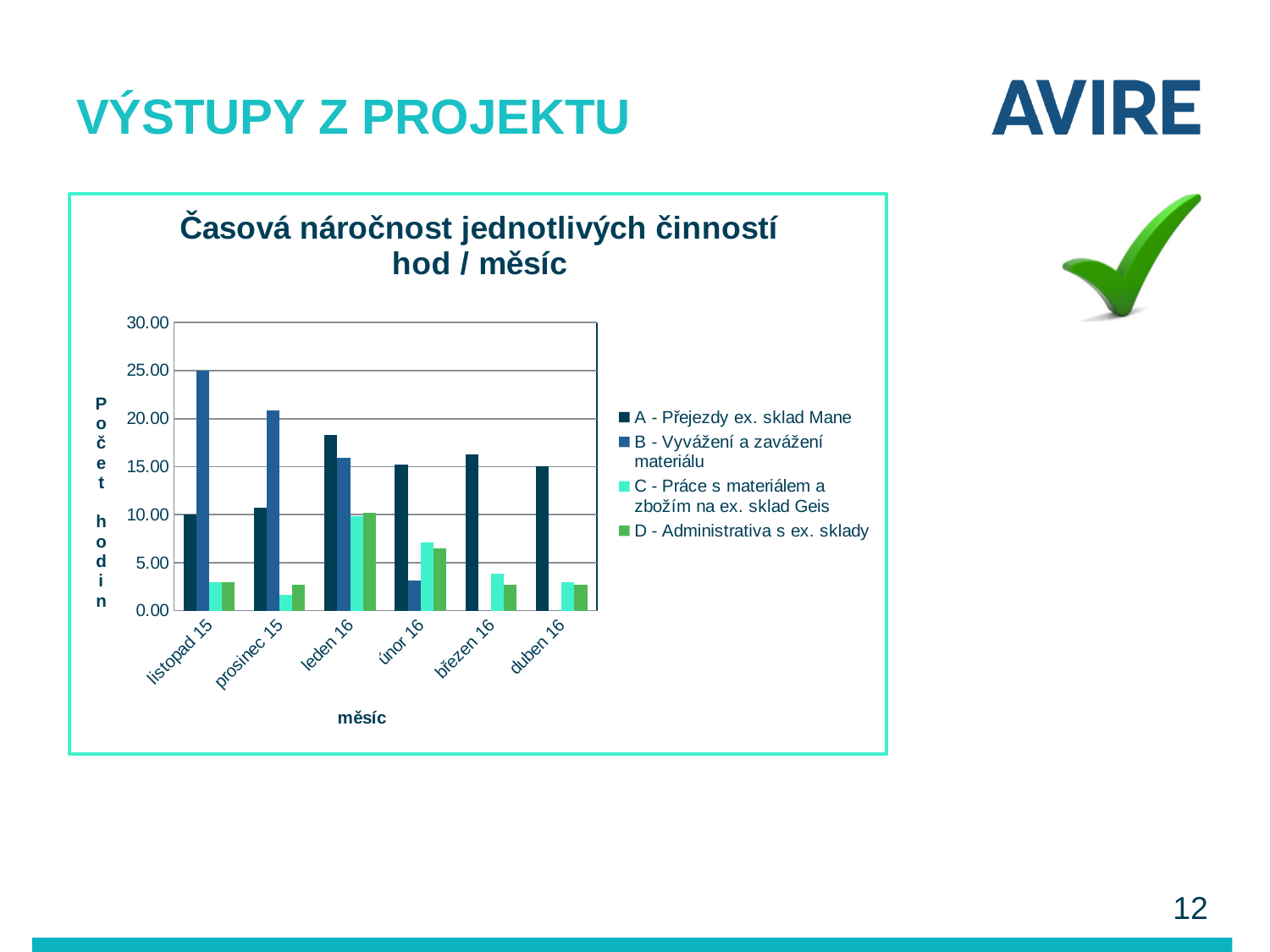
Is the value for 'B - Vyvážení a zavážení materiálu' in listopad 15 greater or less than 20.00? greater What is the title of the x axis? měsíc Is the value for 'C - Práce s materiálem a zbožím na ex. sklad Geis' in leden 16 greater or less than 5.00? greater What kind of chart is shown on the slide? bar chart Is the value for 'A - Přejezdy ex. sklad Mane' in leden 16 greater or less than 15.00? greater How many months are shown on the x axis? 6 In leden 16, which is larger: 'A - Přejezdy ex. sklad Mane' or 'B - Vyvážení a zavážení materiálu'? A - Přejezdy ex. sklad Mane How many series does the legend list? 4 In which month is the value for 'C - Práce s materiálem a zbožím na ex. sklad Geis' the lowest? prosinec 15 In listopad 15, which is larger: 'A - Přejezdy ex. sklad Mane' or 'B - Vyvážení a zavážení materiálu'? B - Vyvážení a zavážení materiálu Does the value for 'B - Vyvážení a zavážení materiálu' rise or fall from listopad 15 to únor 16? fall In which month is the value for 'B - Vyvážení a zavážení materiálu' the highest? listopad 15